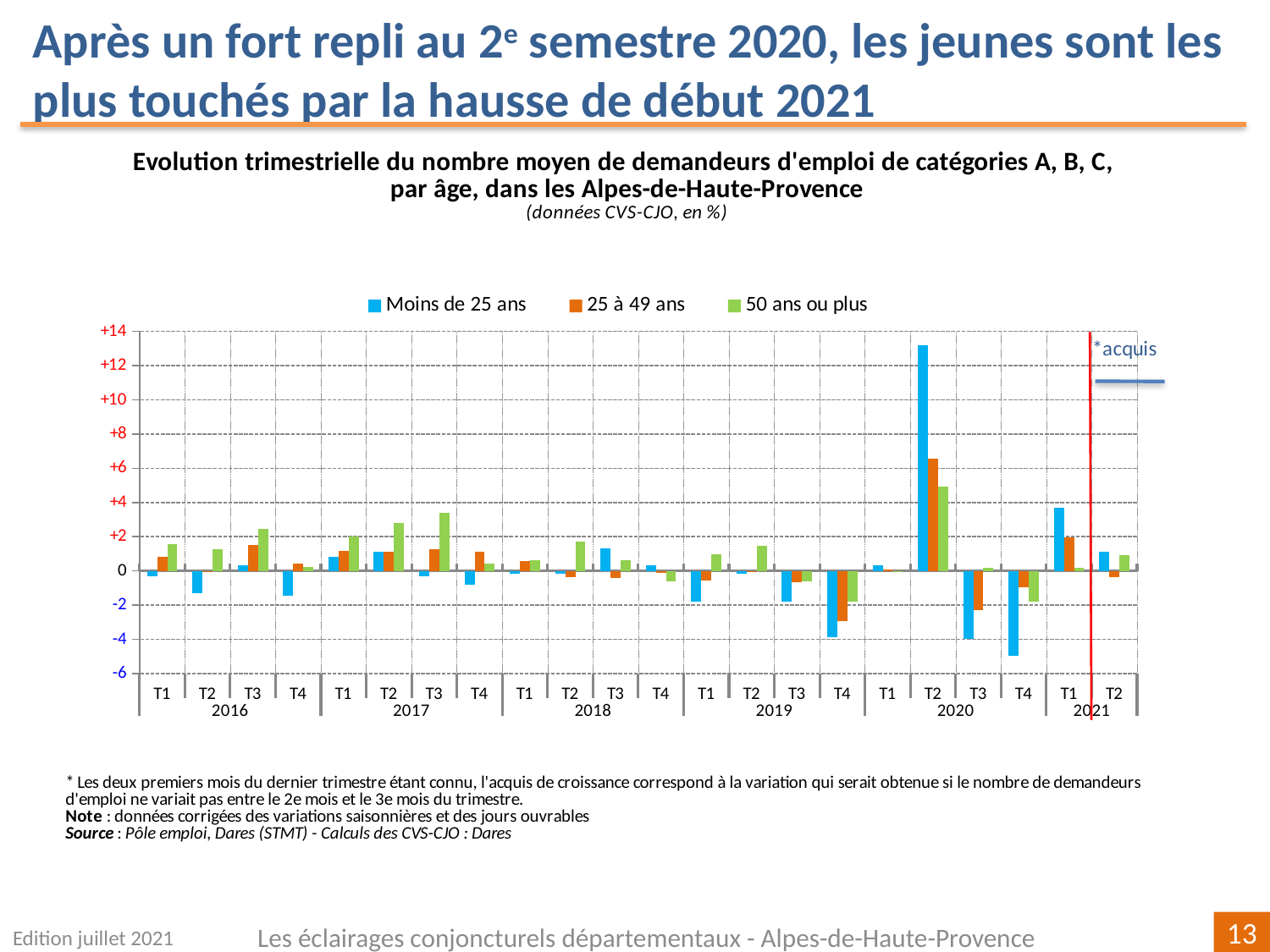
In T3 2017, which series has the larger value: '50 ans ou plus' or '25 à 49 ans'? 50 ans ou plus Is the value for 'Moins de 25 ans' in T2 2020 greater or less than +12? greater How many series does the legend list? 3 Is the value for '50 ans ou plus' in T2 2020 greater or less than +4? greater Which series is shown in blue in the legend? Moins de 25 ans Is the value for 'Moins de 25 ans' in T4 2020 greater or less than -4? less In T2 2020, which series has the larger value: 'Moins de 25 ans' or '25 à 49 ans'? Moins de 25 ans In which quarter does the 'Moins de 25 ans' series reach its lowest value? T4 2020 How many quarters are plotted along the x axis? 22 What kind of chart is shown on the slide? bar chart Which series has the highest value in T1 2021? Moins de 25 ans In which quarter does the 'Moins de 25 ans' series reach its highest value? T2 2020